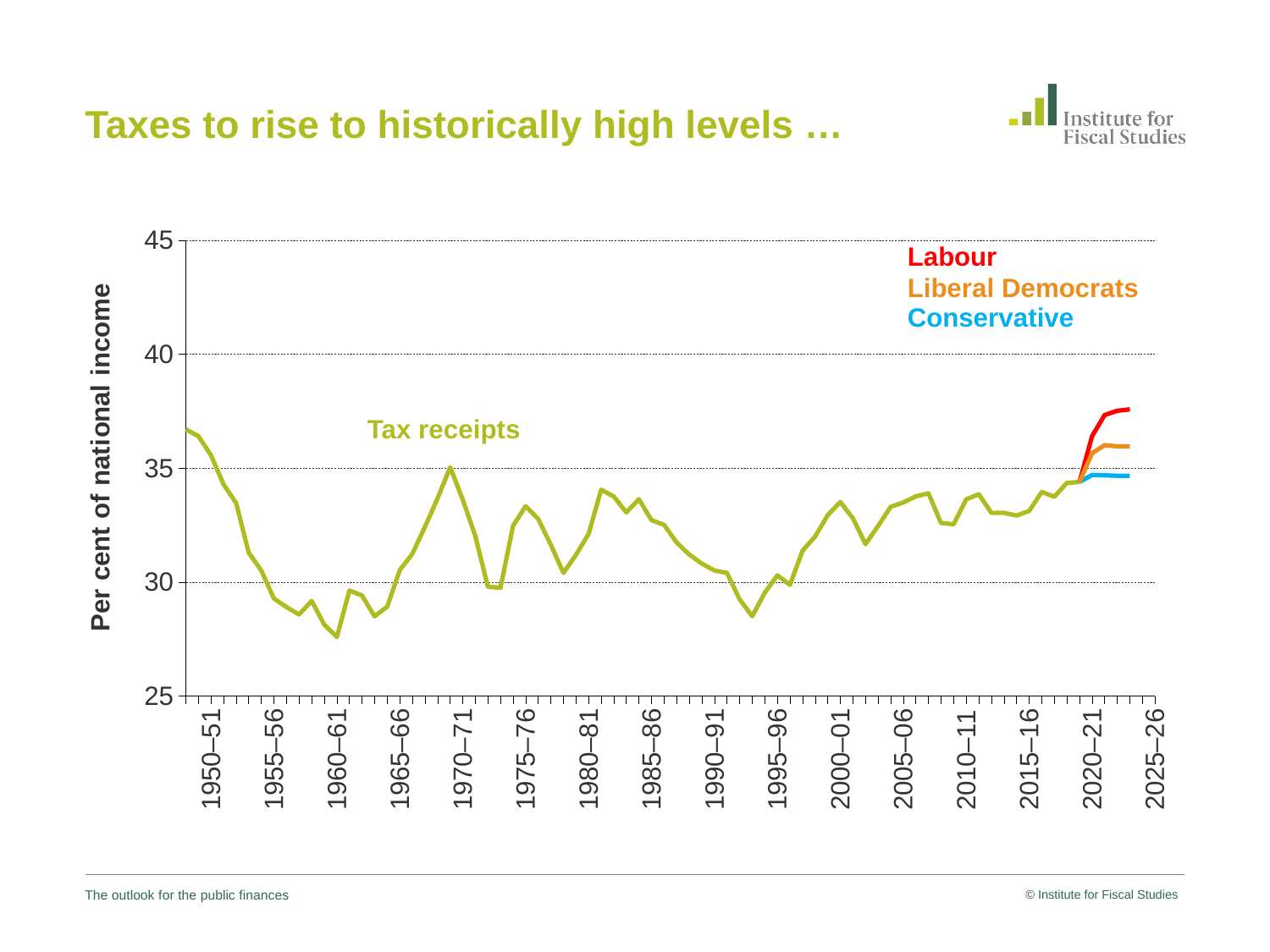
Do tax receipts rise or fall between 1950–51 and 1960–61? fall Is the value for tax receipts in 1985–86 greater or less than 30? greater What kind of chart is shown on the slide? line chart Is the value for tax receipts in 2000–01 greater or less than 35? less What is the label on the vertical axis? Per cent of national income Is the value for tax receipts in 1960–61 greater or less than 30? less Which party's projection line is highest at the end of the chart? Labour Which party's projection line is lowest at the end of the chart? Conservative What colour is the Labour projection line? red Which is larger at 2022–23, the Labour projection or the Conservative projection? Labour How many party projections are labelled in the chart's legend? 3